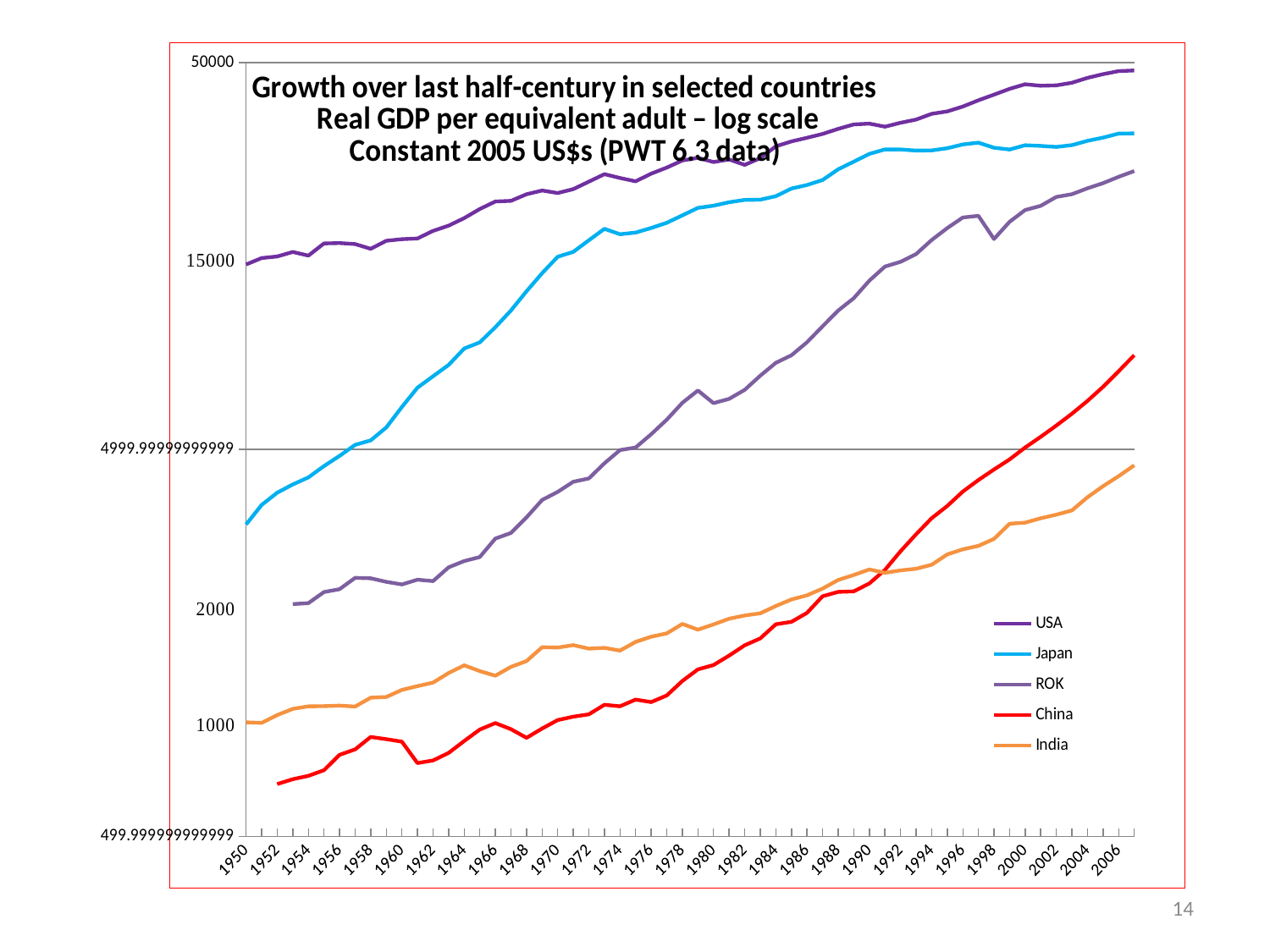
Is the value for Japan in 1950 greater or less than 5000? less Which is larger in 1980, the value for China or the value for India? India Is the value for China in 2006 greater or less than 5000? greater Which is larger in 1980, the value for Japan or the value for ROK? Japan How many series does the legend list? 5 What kind of chart is shown on the slide? line chart According to the title, what kind of scale is used for the y axis? log scale Which series has the lowest value in 2006? India Is the value for ROK in 2006 greater or less than 15000? greater Which series has the highest value in 2006? USA Which countries are listed in the legend? USA, Japan, ROK, China, India Does the China series generally rise or fall from 1952 to 2006? rise